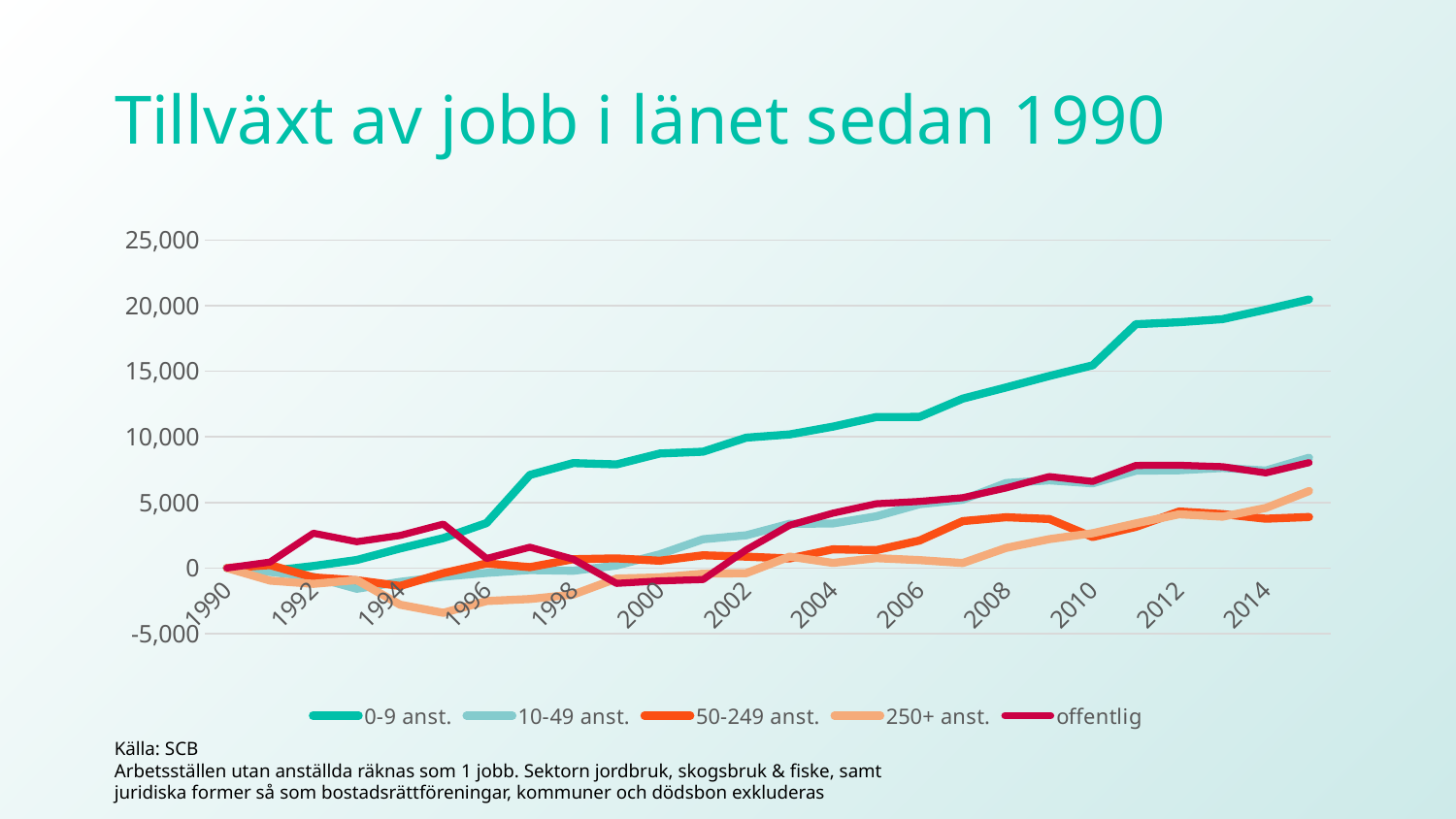
What kind of chart is shown on the slide? line chart What source is cited below the chart? SCB Is the value for 0-9 anst. in 2014 greater or less than 15,000? greater Which series has the highest value at the right end of the chart (2014 and after)? 0-9 anst. Which series has the lowest value around 1996? 250+ anst. What is the title of the chart? Tillväxt av jobb i länet sedan 1990 Is the value for 0-9 anst. in 2010 greater or less than 20,000? less Is the value for 10-49 anst. in 2014 greater or less than 10,000? less Does the 0-9 anst. series generally rise or fall from 1990 to the end of the chart? rise In 2008, which is larger: the value for 50-249 anst. or the value for 250+ anst.? 50-249 anst. How many series does the legend list? 5